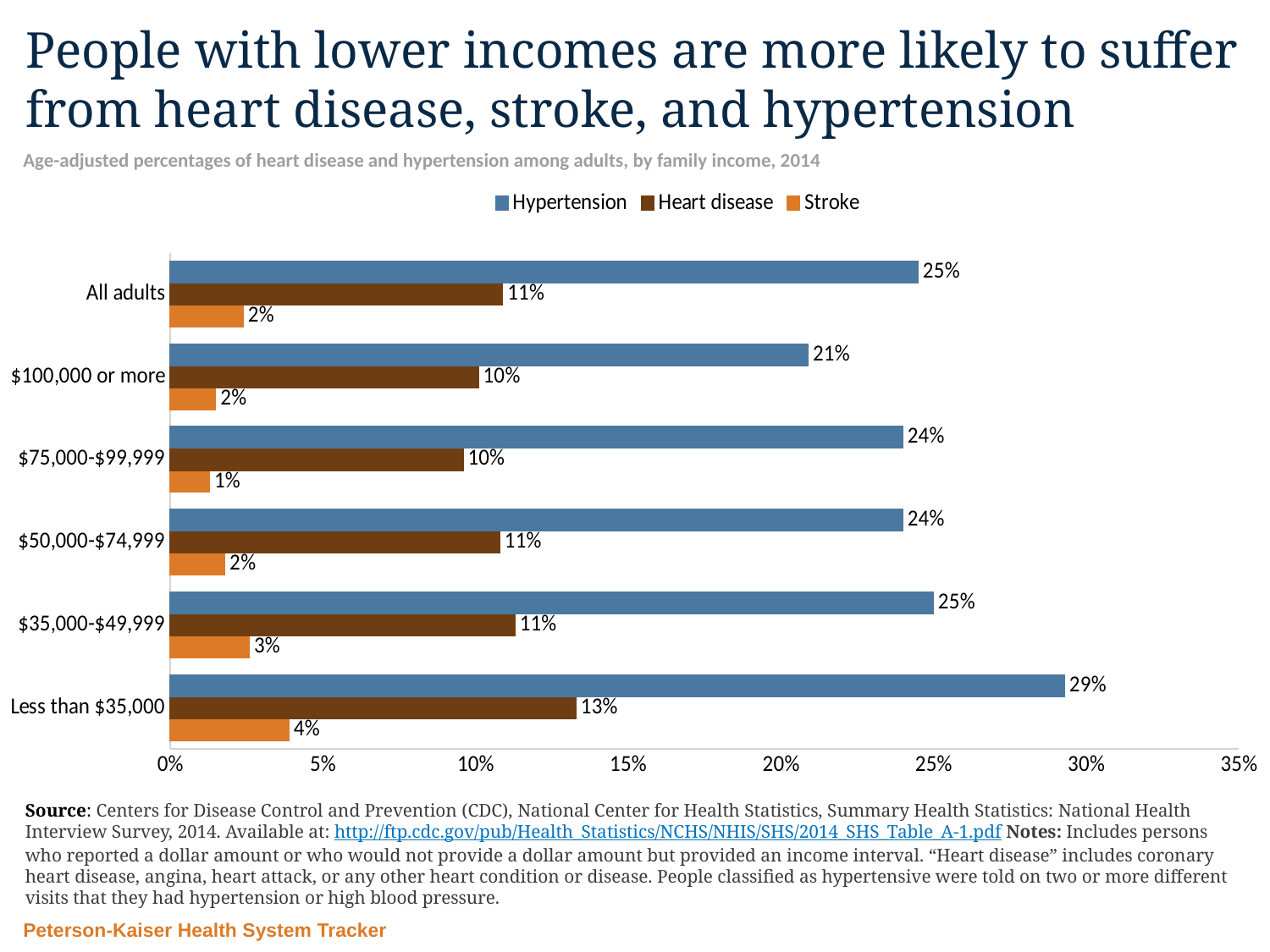
What is the stroke percentage for the $75,000-$99,999 income group? 1% What kind of chart is shown on the slide? Bar chart Is the hypertension value for the $100,000 or more group greater or less than 25%? less How many income categories (including All adults) are shown on the chart? 6 Which series is shown in orange in the legend? Stroke How many series does the legend list? 3 Which income category has the lowest hypertension percentage? $100,000 or more What is the heart disease percentage for all adults? 11% Which income category has the highest hypertension percentage? Less than $35,000 What is the difference in hypertension percentage between the Less than $35,000 group and the $100,000 or more group? 8% What is the hypertension percentage for adults with family income less than $35,000? 29% Which is larger: the heart disease percentage for Less than $35,000 or for $100,000 or more? Less than $35,000